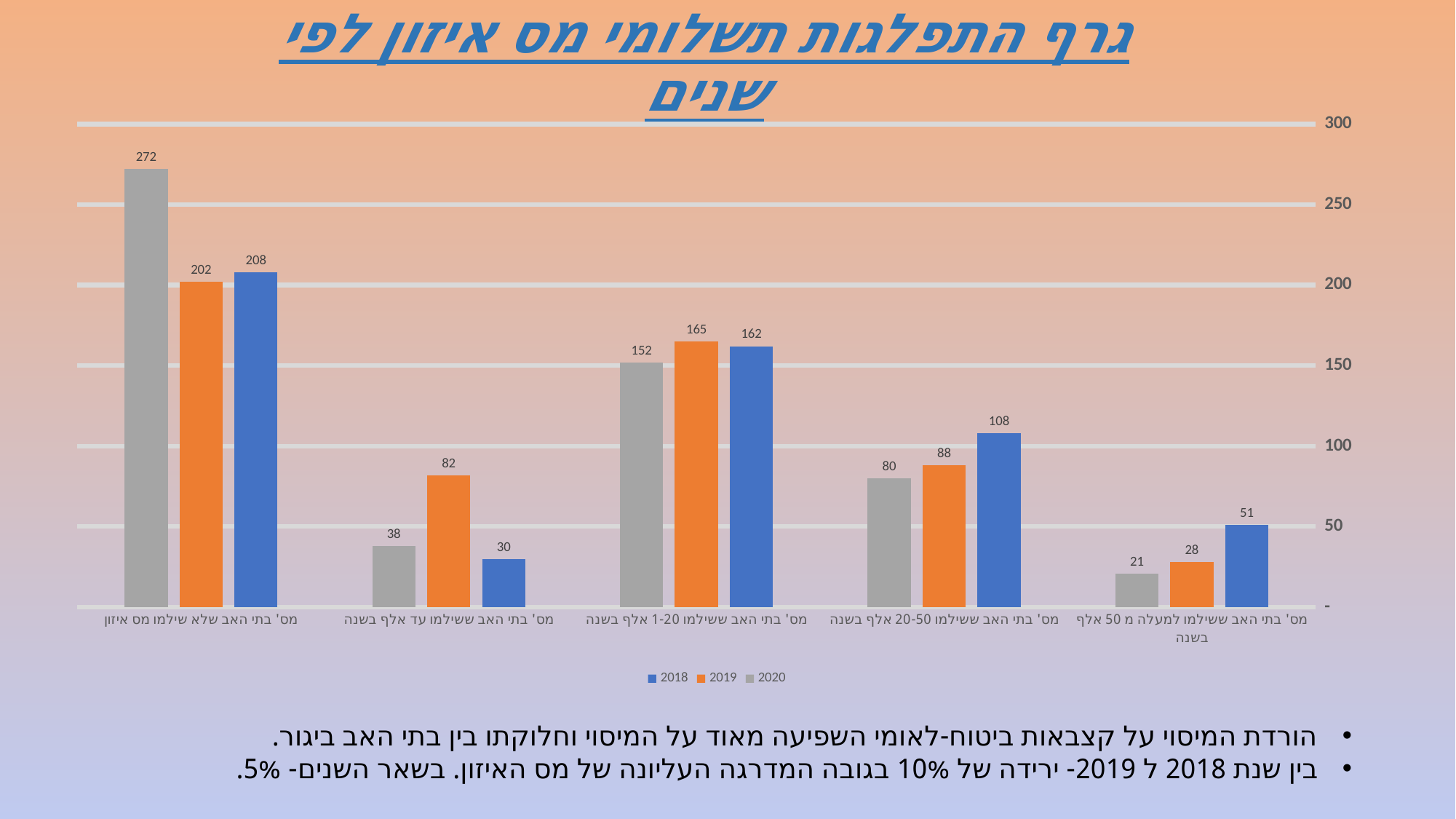
Is the 2019 value for "מס' בתי האב ששילמו 1-20 אלף בשנה" greater or less than 150? greater How many series does the legend list? 3 What is the 2018 value for the category "מס' בתי האב ששילמו למעלה מ 50 אלף בשנה"? 51 Which colour represents the 2019 series in the legend? orange For the category "מס' בתי האב ששילמו 20-50 אלף בשנה", which is larger: the 2018 value or the 2020 value? 2018 What is the difference between the 2020 and 2019 values for "מס' בתי האב שלא שילמו מס איזון"? 70 What is the 2020 value for the category "מס' בתי האב שלא שילמו מס איזון"? 272 Which category has the lowest 2020 value? מס' בתי האב ששילמו למעלה מ 50 אלף בשנה Which category has the highest 2018 value? מס' בתי האב שלא שילמו מס איזון What kind of chart is shown on the slide? bar chart How many categories are shown on the x axis? 5 What is the 2019 value for the category "מס' בתי האב ששילמו עד אלף בשנה"? 82